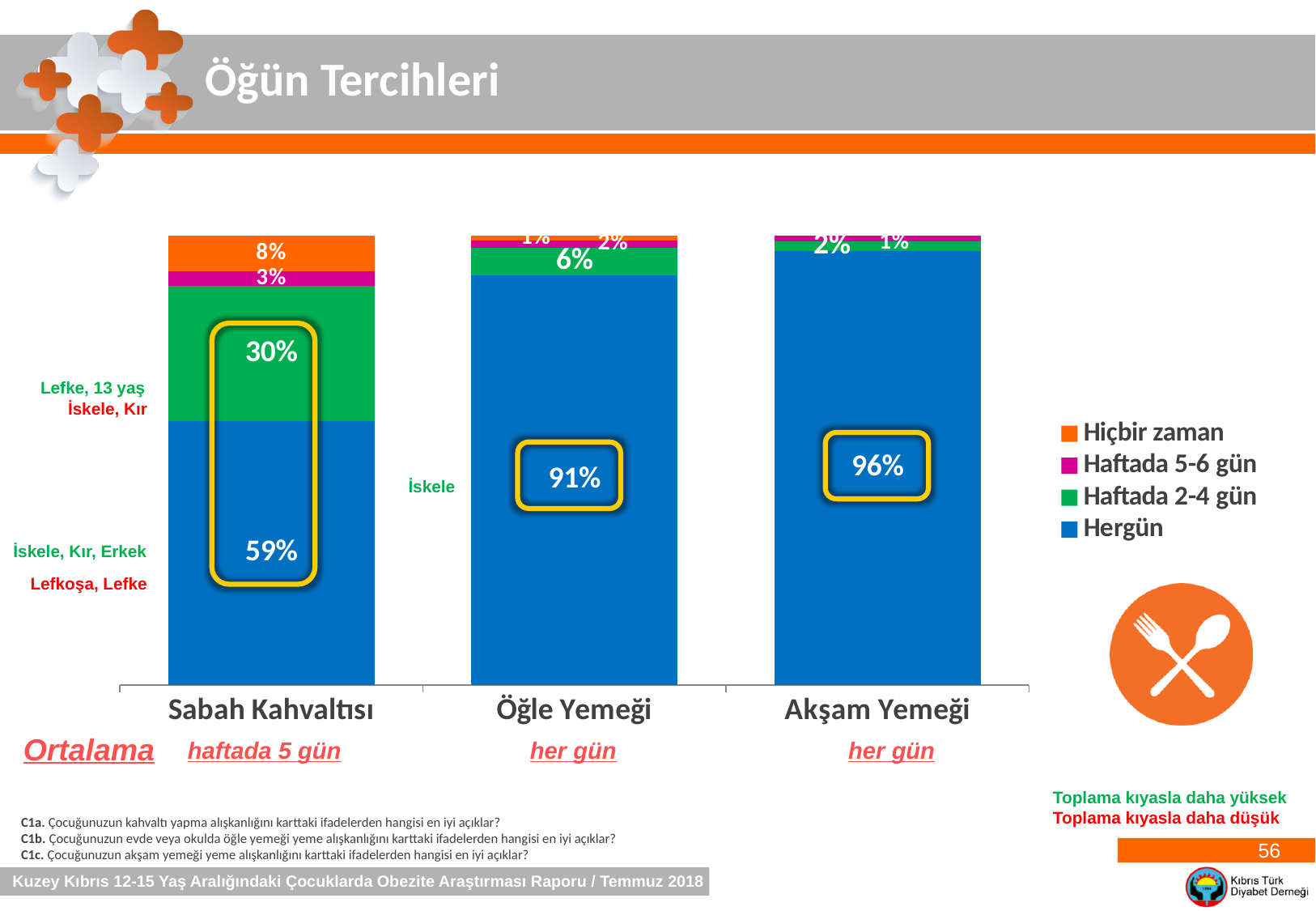
What is the Hergün value for Sabah Kahvaltısı? 59% What is the difference between the Hergün values for Akşam Yemeği and Sabah Kahvaltısı? 37% What is the Haftada 2-4 gün value for Sabah Kahvaltısı? 30% What is the Hiçbir zaman value for Sabah Kahvaltısı? 8% What is the Hergün value for Akşam Yemeği? 96% What is the Haftada 5-6 gün value for Sabah Kahvaltısı? 3% Which meal has the lowest Hergün value? Sabah Kahvaltısı How many series does the legend list? 4 Which meal has the highest Hergün value? Akşam Yemeği How many meal categories are shown on the x axis? 3 What kind of chart is shown on the slide? stacked bar chart What is the Hergün value for Öğle Yemeği? 91%